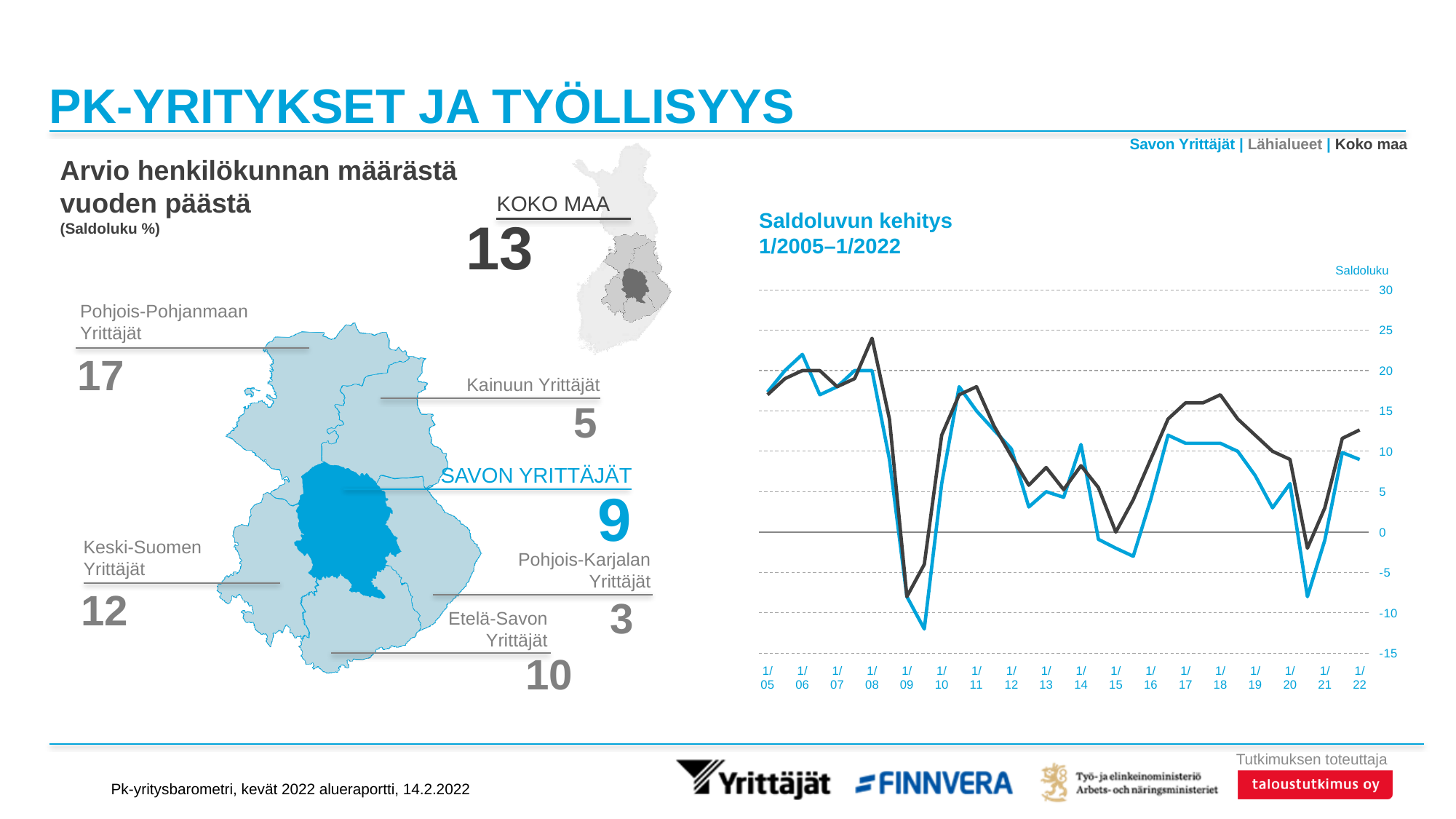
In the chart 'Saldoluvun kehitys 1/2005–1/2022', is the value of the dark line at 1/18 greater or less than 15? greater On the map 'Arvio henkilökunnan määrästä vuoden päästä', what is the value for Koko maa? 13 In the chart 'Saldoluvun kehitys 1/2005–1/2022', do the lines rise or fall between 1/08 and 1/09? fall In the chart 'Saldoluvun kehitys 1/2005–1/2022', how many time points are labelled on the x axis? 18 On the map 'Arvio henkilökunnan määrästä vuoden päästä', what is the value for Savon Yrittäjät? 9 In the chart 'Saldoluvun kehitys 1/2005–1/2022', is the value of the dark line at 1/08 greater or less than 20? greater What kind of chart is 'Saldoluvun kehitys 1/2005–1/2022'? line chart On the map 'Arvio henkilökunnan määrästä vuoden päästä', which region has the highest value? Pohjois-Pohjanmaan Yrittäjät In the chart 'Saldoluvun kehitys 1/2005–1/2022', do the lines rise or fall between 1/21 and 1/22? rise On the map 'Arvio henkilökunnan määrästä vuoden päästä', what is the difference between the values for Pohjois-Pohjanmaan Yrittäjät and Pohjois-Karjalan Yrittäjät? 14